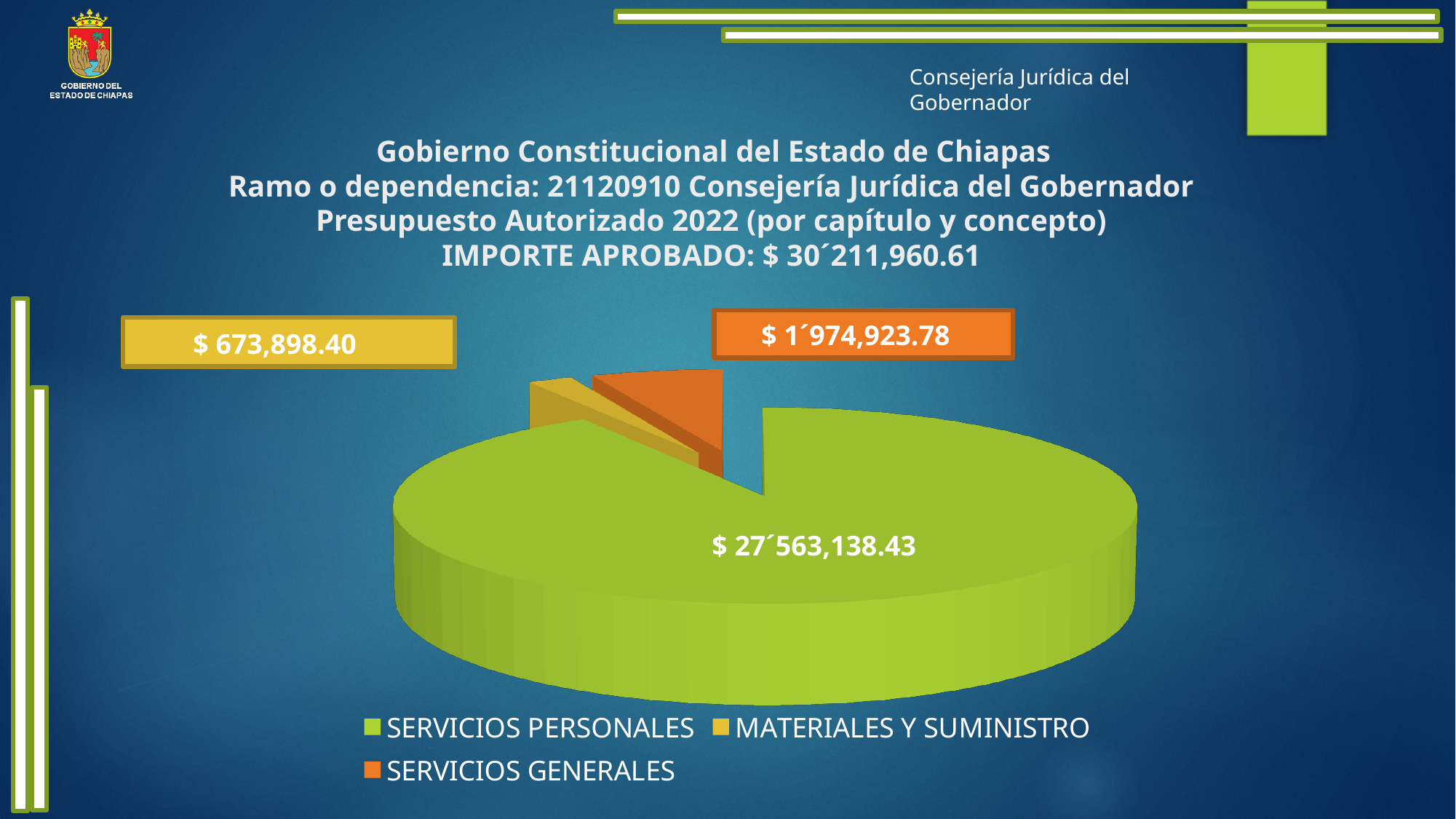
Which category has the largest slice of the pie? SERVICIOS PERSONALES What is the difference between SERVICIOS GENERALES and MATERIALES Y SUMINISTRO? $ 1´301,025.38 What is the difference between SERVICIOS PERSONALES and SERVICIOS GENERALES? $ 25´588,214.65 What share of the total does SERVICIOS PERSONALES represent? 91.2% What kind of chart is shown on the slide? Pie chart What colour is the SERVICIOS GENERALES slice? Orange What is the value for MATERIALES Y SUMINISTRO? $ 673,898.40 Which is larger, SERVICIOS GENERALES or MATERIALES Y SUMINISTRO? SERVICIOS GENERALES How many categories does the pie chart show? 3 What is the value for SERVICIOS GENERALES? $ 1´974,923.78 What is the value for SERVICIOS PERSONALES? $ 27´563,138.43 Which category has the smallest slice of the pie? MATERIALES Y SUMINISTRO